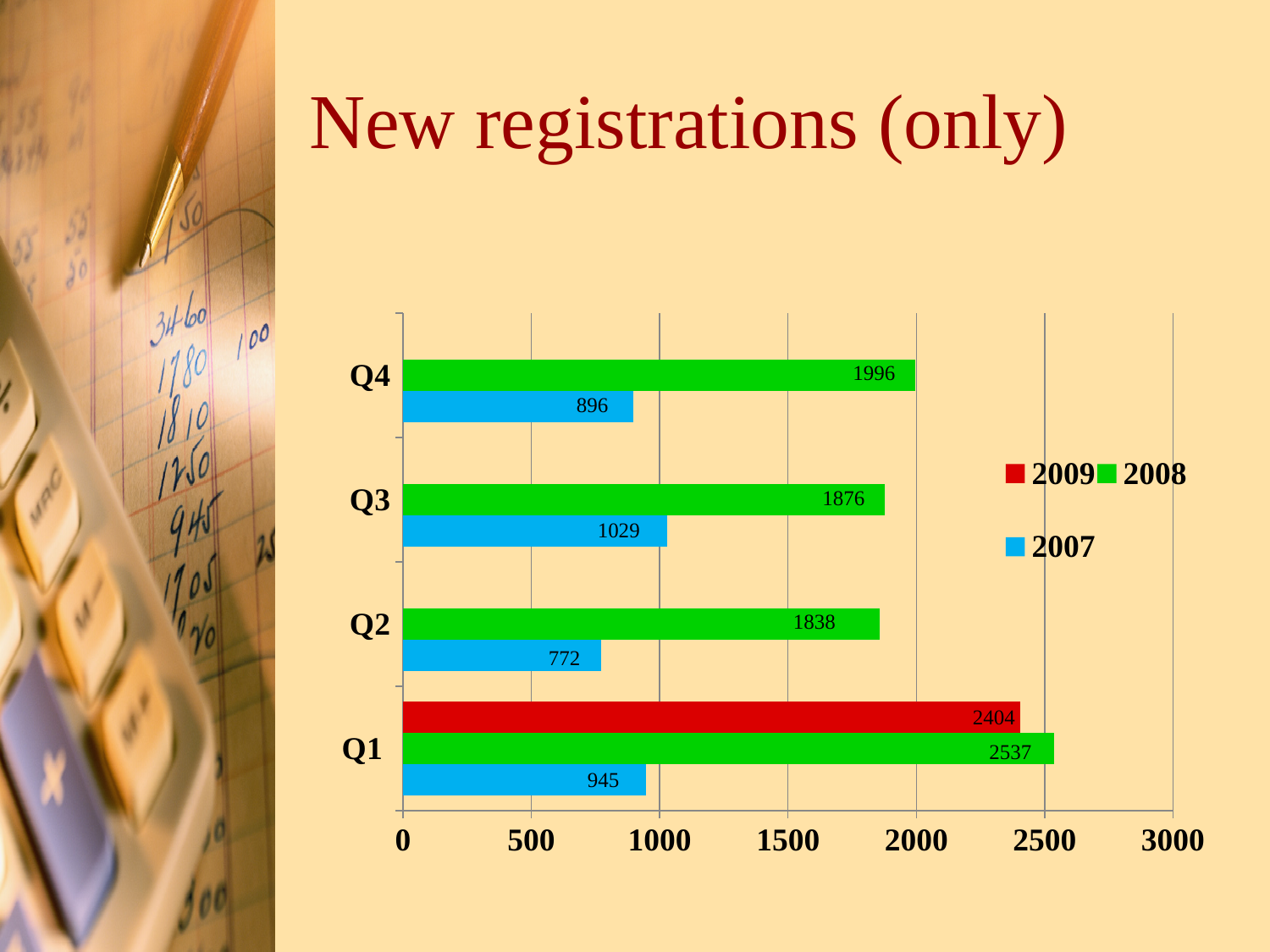
What kind of chart is shown? bar chart Is the value for 2007 in Q1 greater or less than 1000? less What is the difference between the 2008 and 2007 values in Q4? 1100 What is the value for 2007 in Q3? 1029 Which is larger in Q1, the 2009 value or the 2008 value? 2008 Which quarter has the highest value for 2008? Q1 How many quarters are shown on the chart? 4 Which quarter has the lowest value for 2007? Q2 What is the title of the slide? New registrations (only) What is the value for 2008 in Q1? 2537 How many series does the legend list? 3 What is the value for 2009 in Q1? 2404